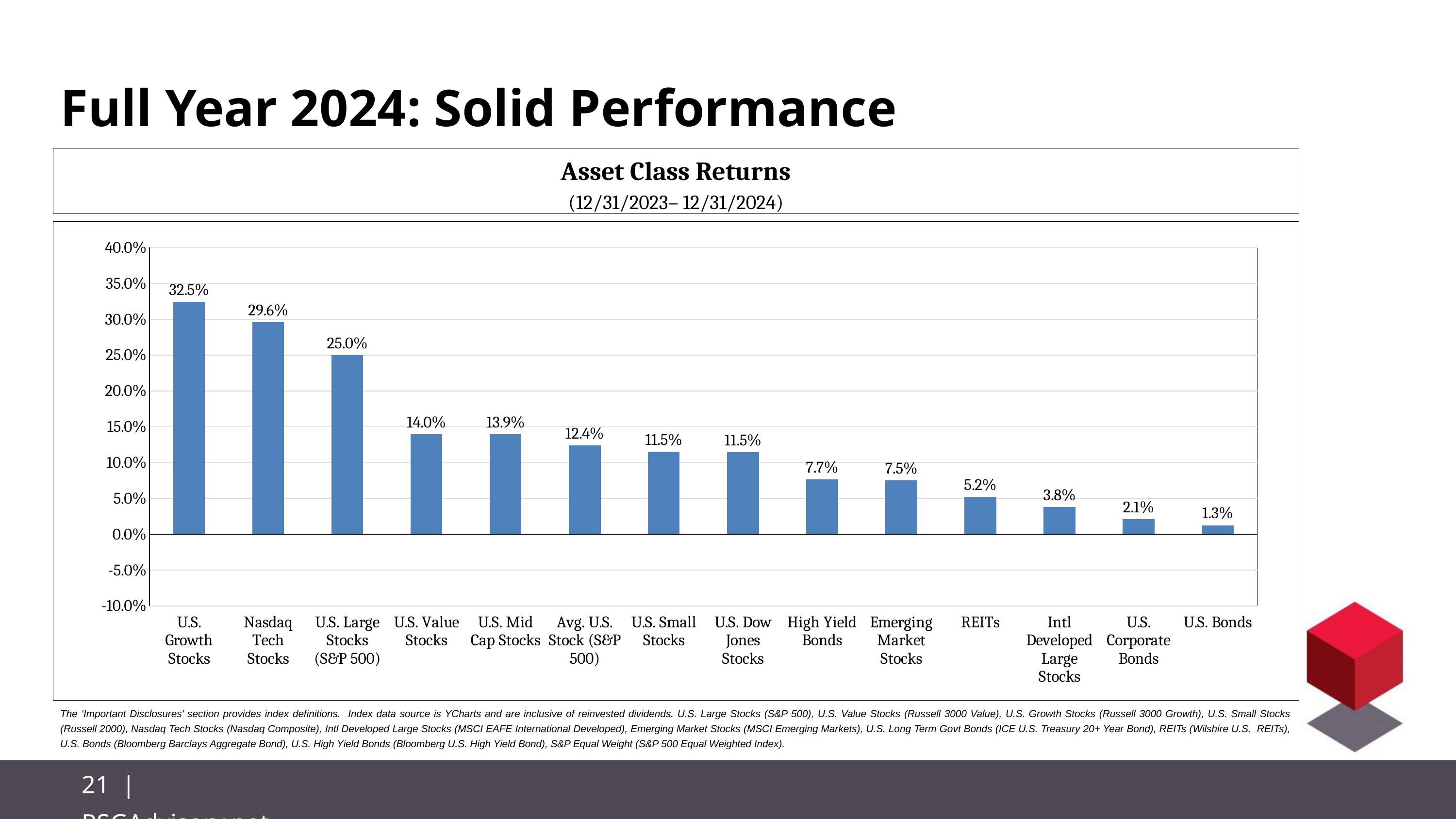
Which asset class has the highest return? U.S. Growth Stocks What is the title of the chart? Asset Class Returns How many asset classes are shown in the chart? 14 What is the return for REITs? 5.2% What is the return for Emerging Market Stocks? 7.5% What is the difference between the returns of U.S. Growth Stocks and Nasdaq Tech Stocks? 2.9% What kind of chart is shown on the slide? bar chart Which asset class has the lowest return? U.S. Bonds What is the difference between the returns of U.S. Large Stocks (S&P 500) and U.S. Value Stocks? 11.0% What is the return for U.S. Growth Stocks? 32.5% Which has a higher return, High Yield Bonds or Intl Developed Large Stocks? High Yield Bonds Is the return for U.S. Corporate Bonds greater or less than 5.0%? less